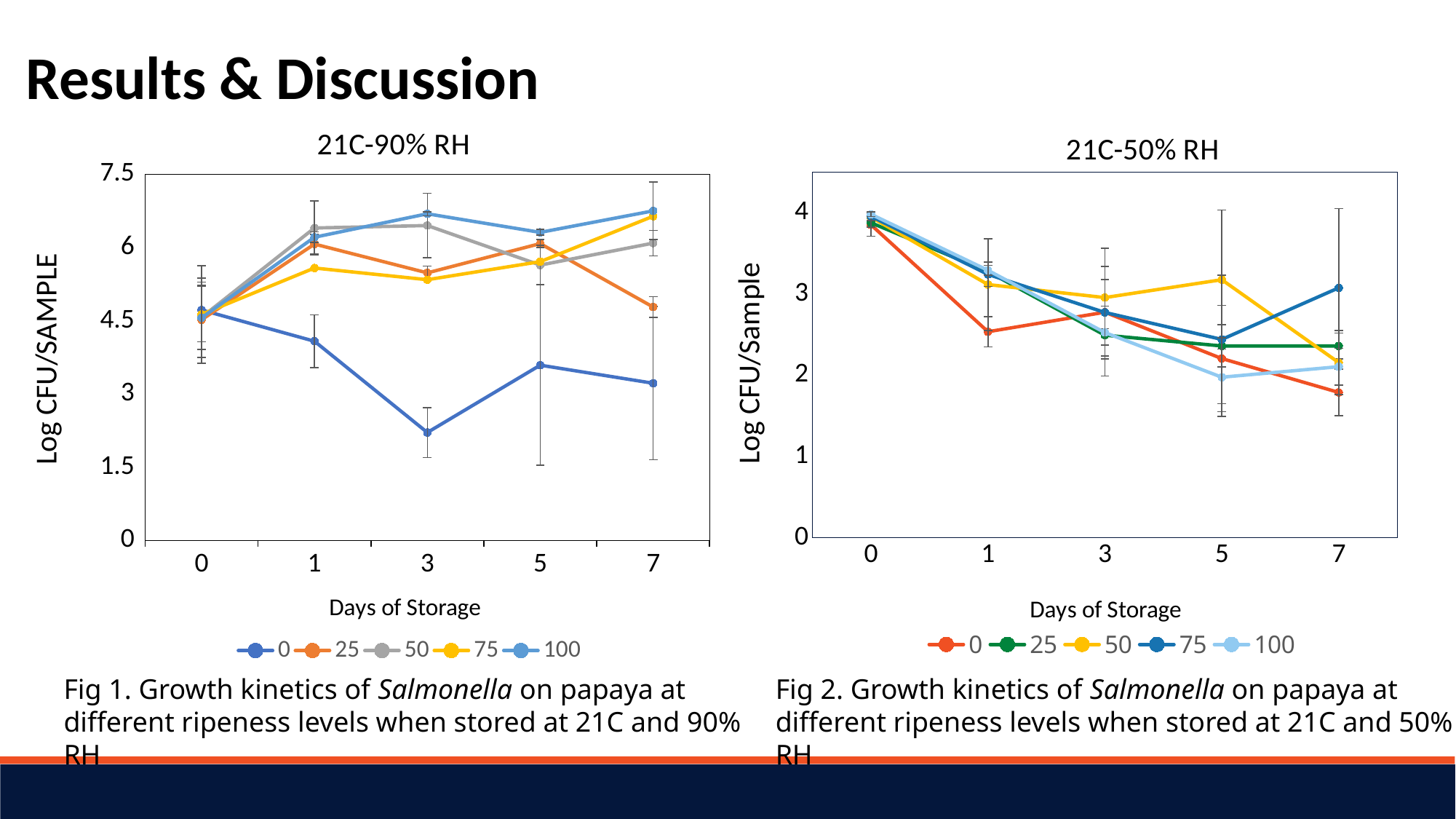
In the "21C-50% RH" chart, at day 1, which is larger: series 50 or series 0? 50 How many series does the legend of the "21C-50% RH" chart list? 5 In the "21C-50% RH" chart, is the value for series 0 at day 7 greater or less than 2? less In the "21C-50% RH" chart, which series is highest at day 7? 75 In the "21C-50% RH" chart, does series 0 rise or fall overall from day 0 to day 7? fall What kind of chart is the "21C-90% RH" chart? line chart In the "21C-90% RH" chart, is the value for series 100 at day 7 greater or less than 6? greater In the "21C-90% RH" chart, is the value for series 0 at day 3 greater or less than 3? less In the "21C-90% RH" chart, does series 0 rise or fall overall from day 0 to day 7? fall How many days of storage are plotted on the x axis of the "21C-90% RH" chart? 5 In the "21C-90% RH" chart, which series is lowest at day 3? 0 What is the y-axis label of the "21C-50% RH" chart? Log CFU/Sample